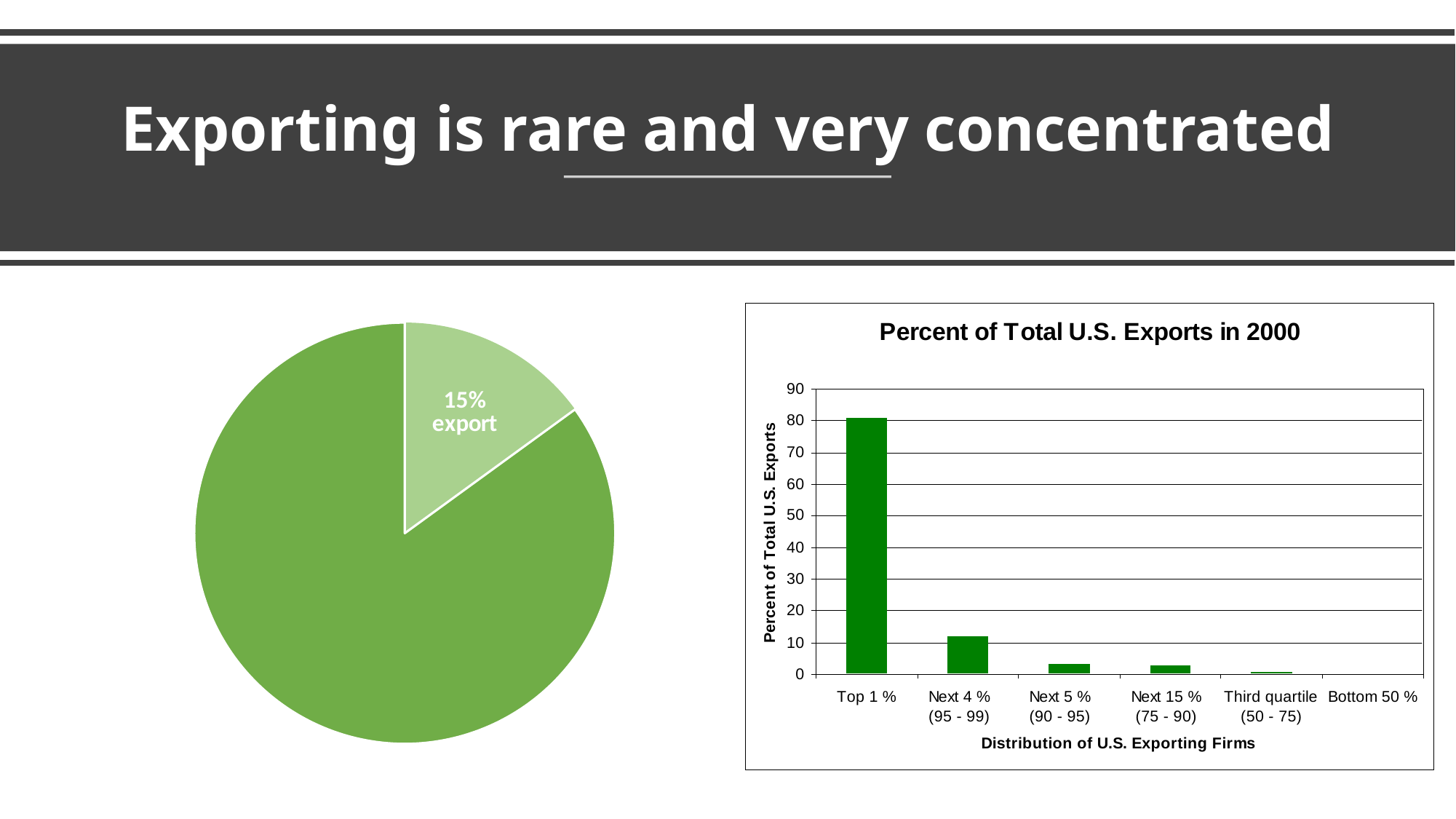
What is the x-axis title of the chart 'Percent of Total U.S. Exports in 2000'? Distribution of U.S. Exporting Firms In 'Percent of Total U.S. Exports in 2000', which category has the highest value? Top 1 % What kind of chart is 'Percent of Total U.S. Exports in 2000'? bar chart In 'Percent of Total U.S. Exports in 2000', which is larger, the value for Next 4 % (95 - 99) or the value for Next 15 % (75 - 90)? Next 4 % (95 - 99) In 'Percent of Total U.S. Exports in 2000', do the values rise or fall moving from left to right along the x axis? fall In 'Percent of Total U.S. Exports in 2000', how many categories are shown on the x axis? 6 In 'Percent of Total U.S. Exports in 2000', is the value for Top 1 % greater or less than 70? greater In 'Percent of Total U.S. Exports in 2000', is the value for Next 5 % (90 - 95) greater or less than 10? less In 'Percent of Total U.S. Exports in 2000', is the value for Next 4 % (95 - 99) greater or less than 20? less How many slices does the pie chart on the left have? 2 What kind of chart is the chart on the left of the slide? pie chart In the pie chart on the left, what share of the pie does the 'export' slice represent? 15%